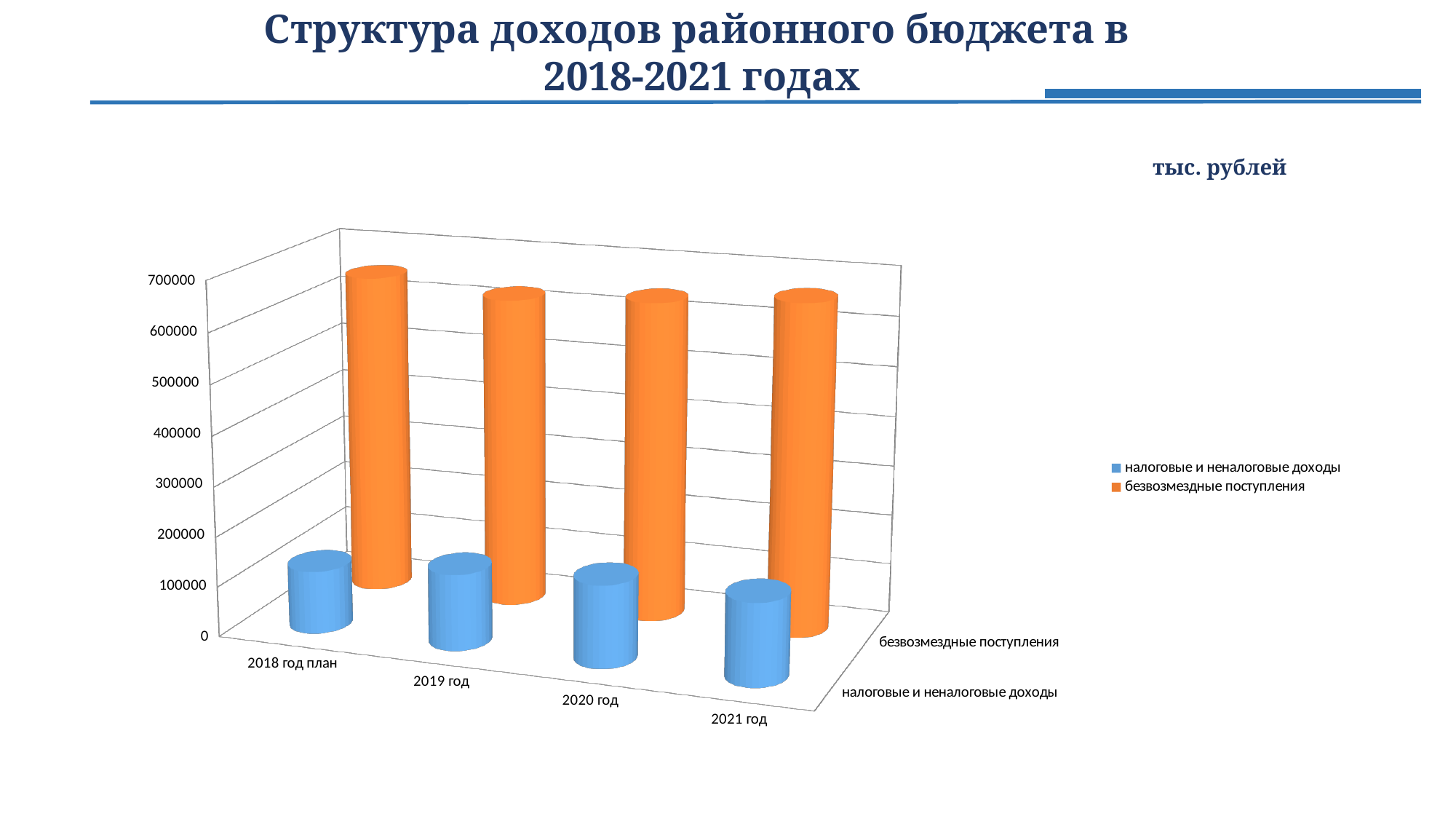
Which series is larger in 2021 год: налоговые и неналоговые доходы or безвозмездные поступления? безвозмездные поступления Is the value for налоговые и неналоговые доходы in 2021 год greater or less than 400000? less Which series is larger in 2019 год: налоговые и неналоговые доходы or безвозмездные поступления? безвозмездные поступления What kind of chart is shown on the slide? bar chart Is the value for налоговые и неналоговые доходы in 2018 год план greater or less than 300000? less How many series does the chart legend list? 2 How many year categories are shown on the x axis of the chart? 4 Is the value for безвозмездные поступления in 2020 год greater or less than 300000? greater What unit of measurement is indicated above the chart? тыс. рублей What colour represents the series безвозмездные поступления in the chart? orange